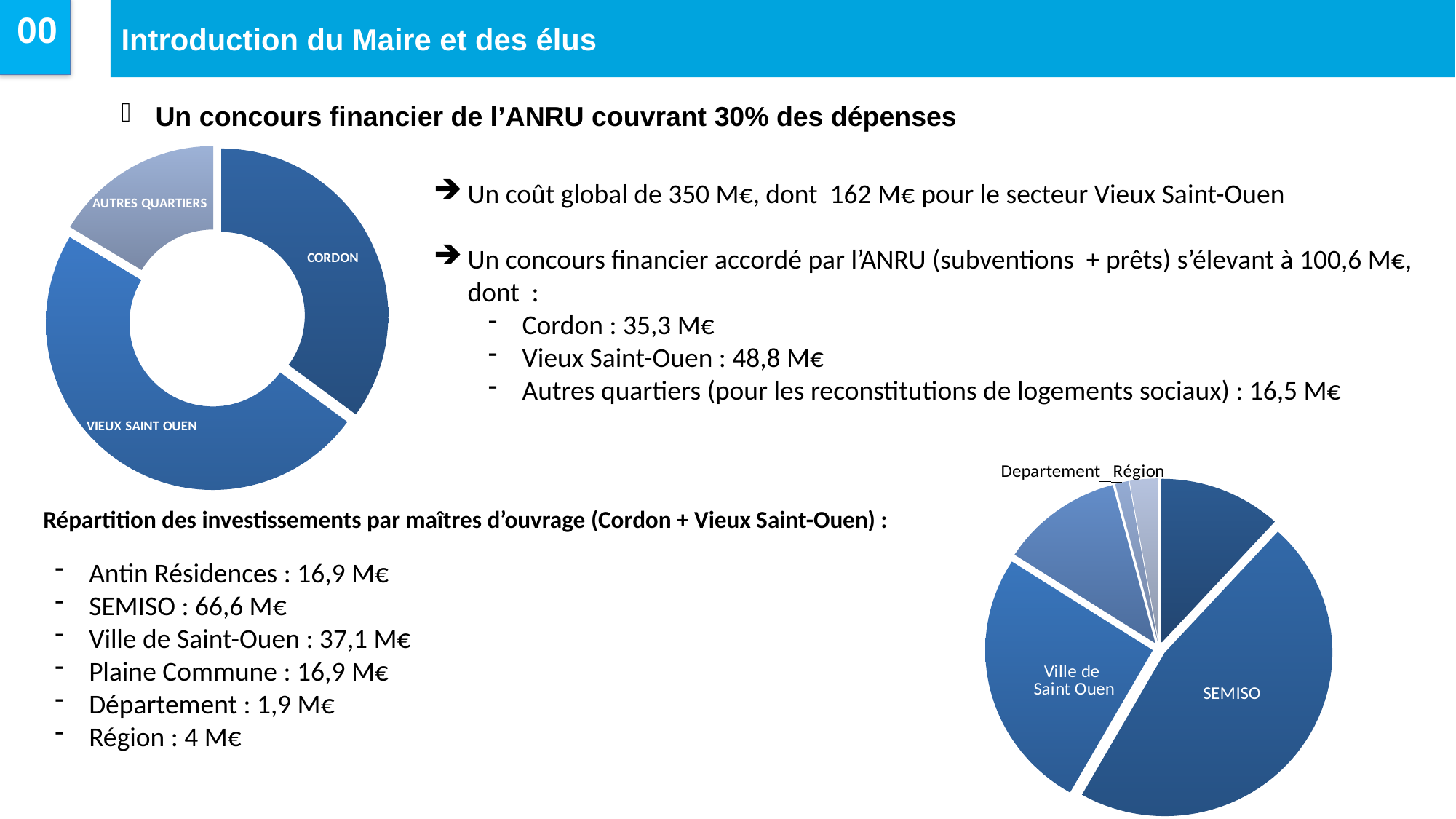
In the doughnut chart on the left, which segment is the smallest? AUTRES QUARTIERS In the pie chart at the bottom right, which is larger, Région or Departement? Région In the doughnut chart on the left, what is the ANRU contribution for Cordon as stated on the slide? 35,3 M€ In the pie chart at the bottom right, which is larger, SEMISO or Ville de Saint Ouen? SEMISO In the doughnut chart on the left, which is larger, CORDON or AUTRES QUARTIERS? CORDON In the doughnut chart on the left, which segment is the largest? VIEUX SAINT OUEN In the doughnut chart on the left, what is the ANRU contribution for Vieux Saint-Ouen as stated on the slide? 48,8 M€ What kind of chart is the chart on the left of the slide? doughnut chart In the pie chart at the bottom right, how many slices have a label printed on the chart? 4 What kind of chart is the chart at the bottom right of the slide? pie chart In the doughnut chart on the left, how many segments are there? 3 In the pie chart at the bottom right, which slice is the largest? SEMISO